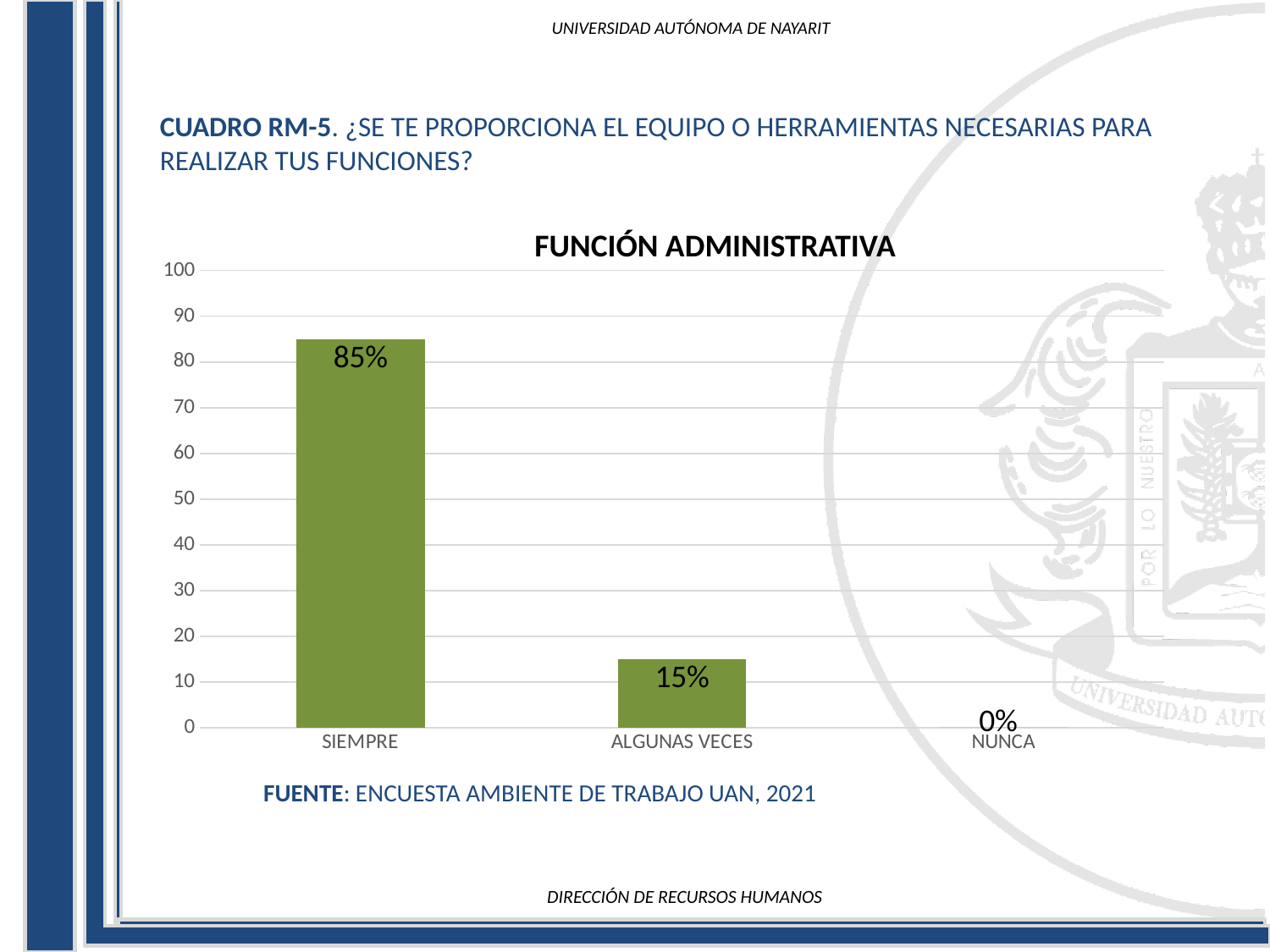
What kind of chart is shown? bar chart What is the difference between the values for SIEMPRE and ALGUNAS VECES? 70% Which is larger, the value for ALGUNAS VECES or the value for NUNCA? ALGUNAS VECES What is the value for ALGUNAS VECES? 15% Do the values rise or fall from left to right along the x axis? fall Which category has the lowest value? NUNCA What is the value for NUNCA? 0% Which category has the highest value? SIEMPRE What is the value for SIEMPRE? 85% How many categories are shown on the x axis? 3 Is the value for SIEMPRE greater or less than 80? greater What is the title of the chart? FUNCIÓN ADMINISTRATIVA